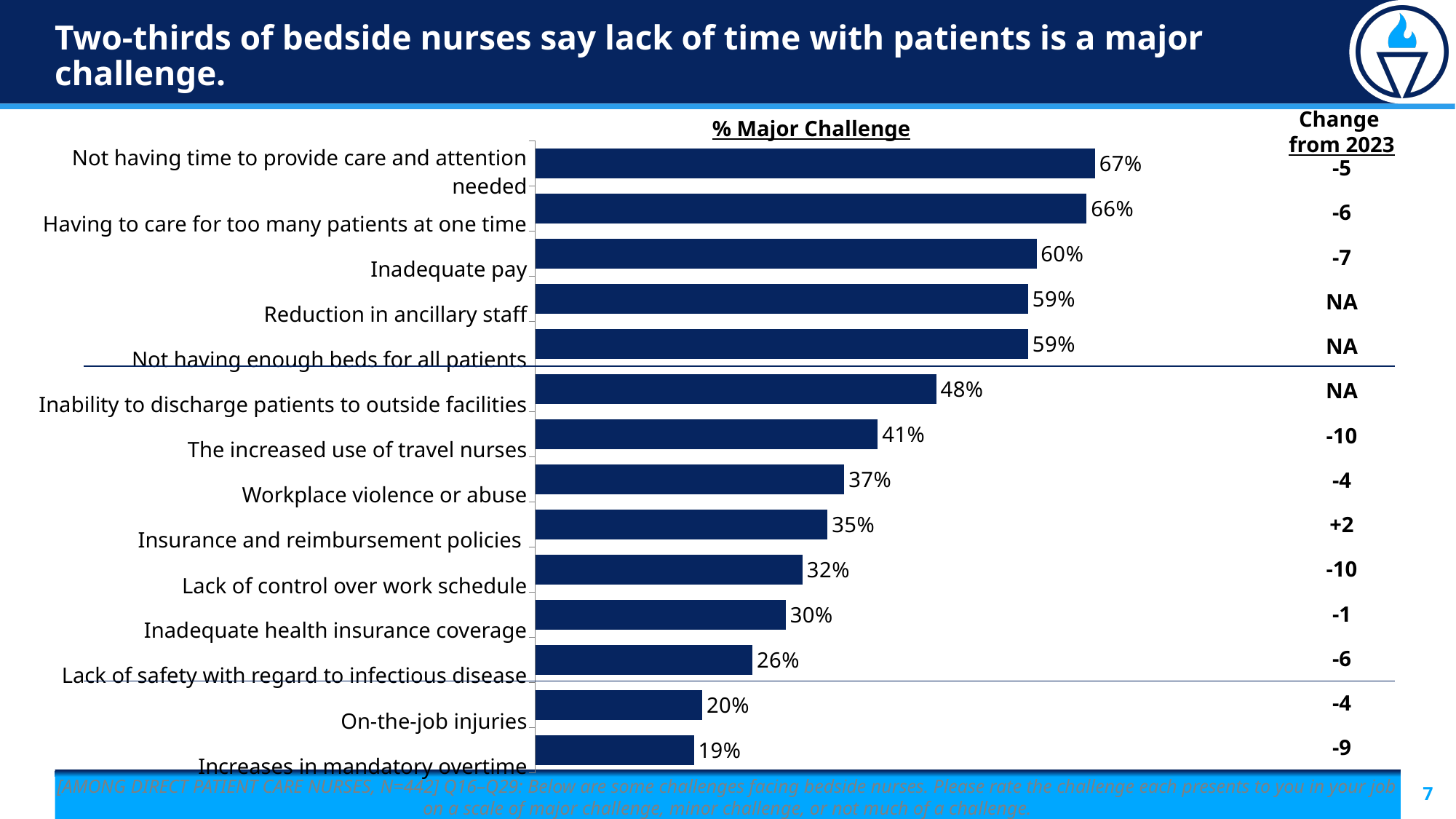
What is the value for 'Workplace violence or abuse'? 37% What percentage of bedside nurses say inadequate pay is a major challenge? 60% What is the difference between the percentages for 'The increased use of travel nurses' and 'Lack of control over work schedule'? 9 percentage points What percentage is shown for 'Inability to discharge patients to outside facilities'? 48% How many challenges are plotted in the chart? 14 What is the title shown above the bars in the chart? % Major Challenge Which is larger: the value for 'Inadequate health insurance coverage' or the value for 'Lack of safety with regard to infectious disease'? Inadequate health insurance coverage Which challenge has the lowest percentage? Increases in mandatory overtime What is the difference between the top two challenges, 'Not having time to provide care and attention needed' and 'Having to care for too many patients at one time'? 1 percentage point Which challenge has the highest percentage of nurses calling it a major challenge? Not having time to provide care and attention needed What kind of chart is shown on the slide? Bar chart What is the value for 'On-the-job injuries'? 20%